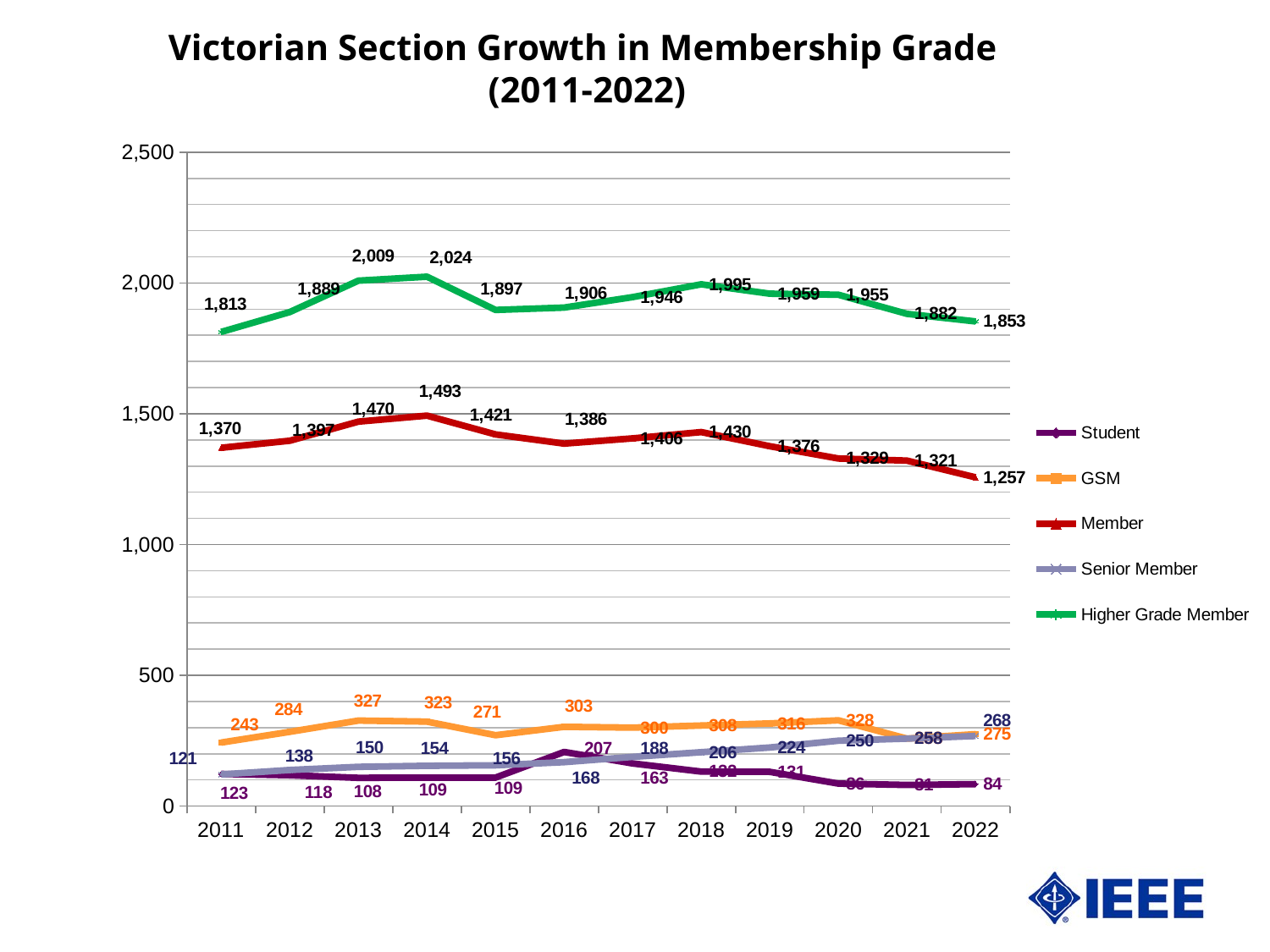
Does the Senior Member series rise or fall from 2011 to 2022? rise Which is larger in 2016, the Student value or the Senior Member value? Student How many years are plotted along the x axis? 12 What is the value for Senior Member in 2019? 224 How many series does the legend list? 5 What is the value for Member in 2022? 1,257 What is the value for GSM in 2013? 327 What is the difference between the Member values in 2014 and 2022? 236 In which year is the Higher Grade Member series at its highest? 2014 In which year is the Member series at its lowest? 2022 What is the value for Higher Grade Member in 2014? 2,024 What type of chart is shown on the slide? line chart